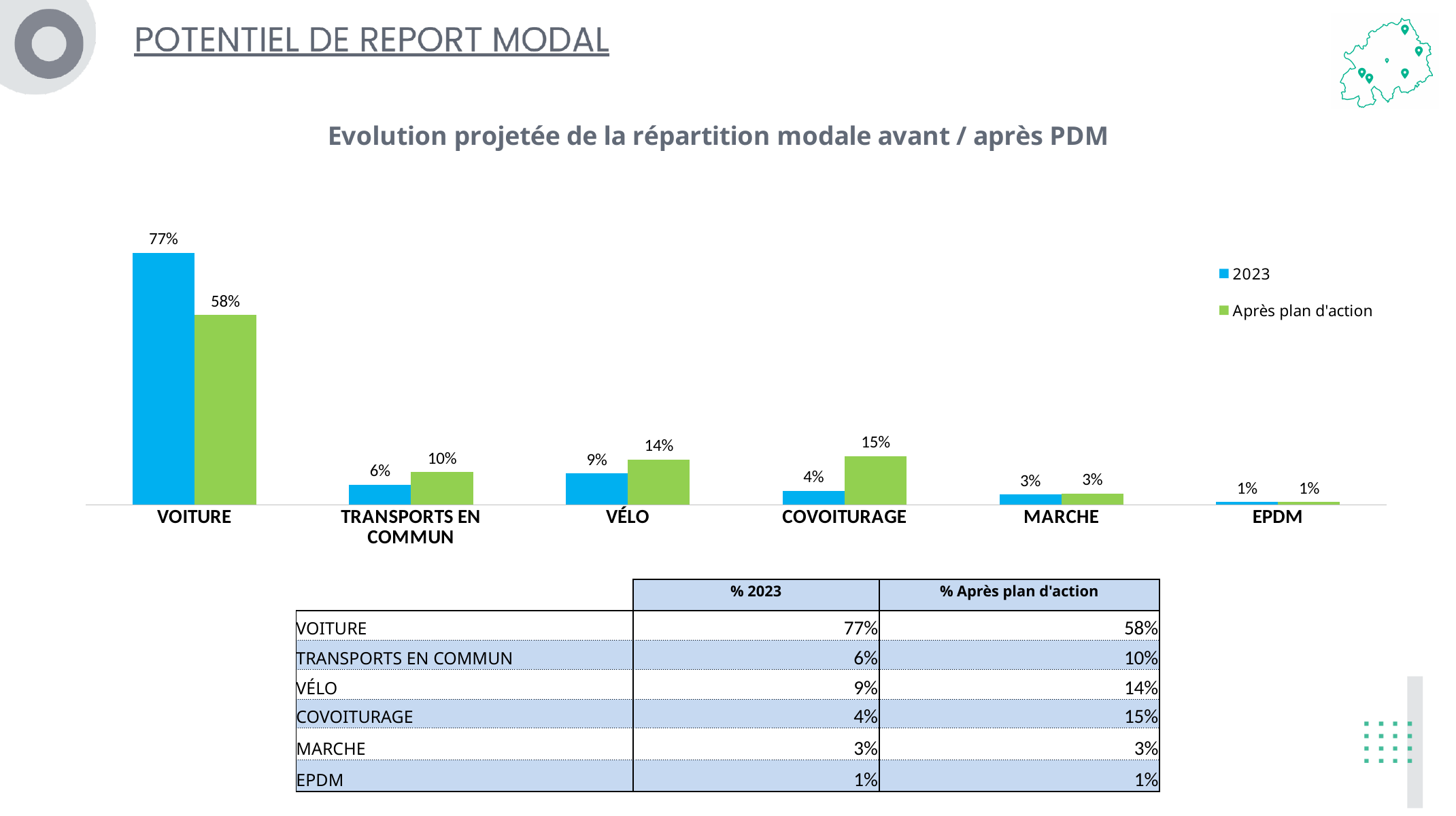
What is the 2023 value for VÉLO? 9% Which category has the highest 2023 value? VOITURE What is the difference between the 2023 and Après plan d'action values for VOITURE? 19% How many categories are shown on the x axis? 6 Which is larger for COVOITURAGE: the 2023 value or the Après plan d'action value? Après plan d'action Which category has the lowest Après plan d'action value? EPDM What is the Après plan d'action value for COVOITURAGE? 15% How many series does the legend list? 2 What is the Après plan d'action value for TRANSPORTS EN COMMUN? 10% What is the title of the chart? Evolution projetée de la répartition modale avant / après PDM What is the 2023 value for VOITURE? 77% What kind of chart is shown? Bar chart